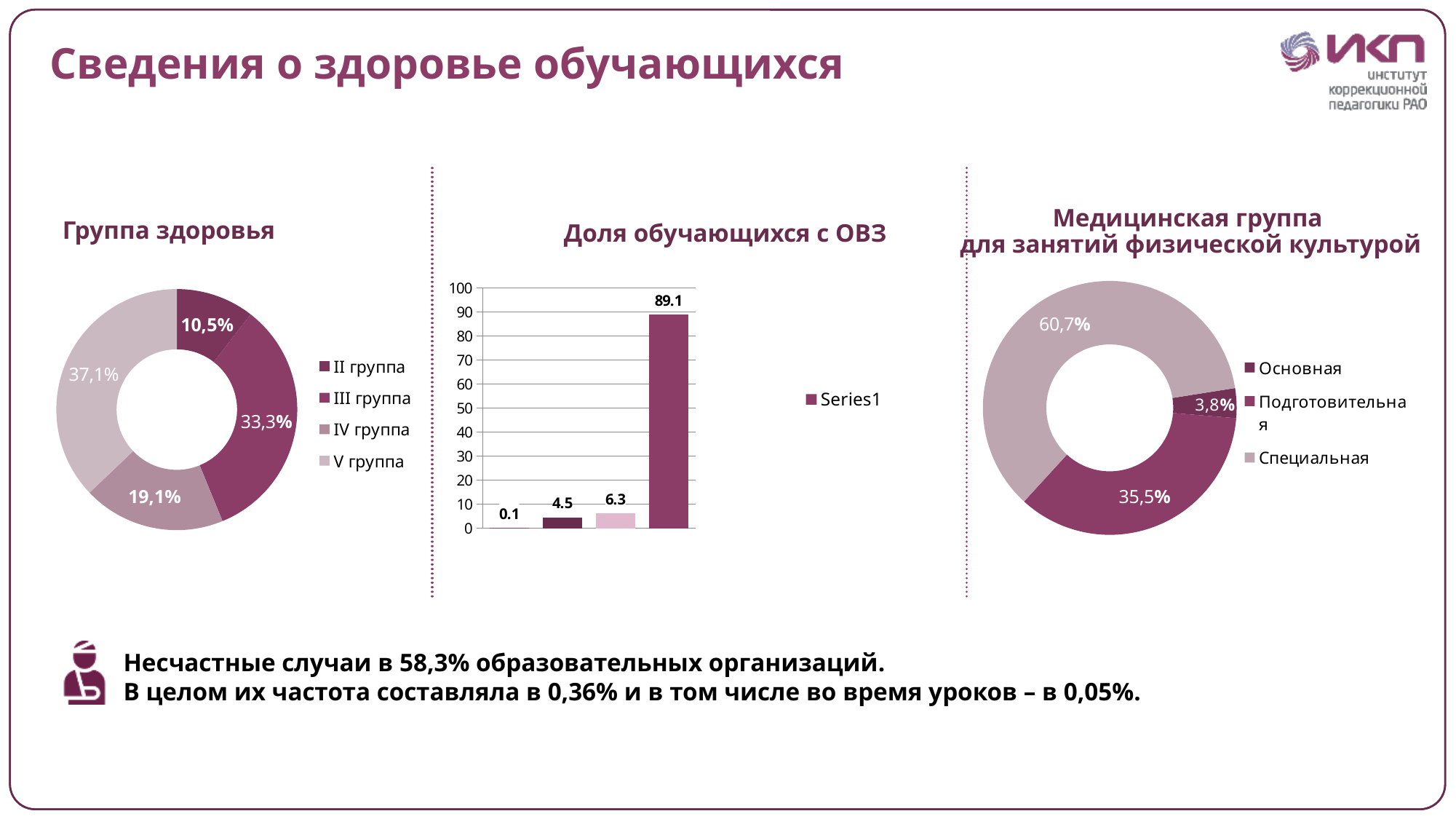
In the 'Группа здоровья' chart, what is the value for III группа? 33,3% What kind of chart is 'Доля обучающихся с ОВЗ'? bar chart In the 'Медицинская группа для занятий физической культурой' chart, what is the value for Специальная? 60,7% In the 'Группа здоровья' chart, which group has the largest share? V группа In the 'Доля обучающихся с ОВЗ' chart, what is the value of the tallest bar? 89.1 In the 'Доля обучающихся с ОВЗ' chart, how many bars are plotted? 4 In the 'Группа здоровья' chart, which group has the smallest share? II группа In the 'Медицинская группа для занятий физической культурой' chart, which is larger: Основная or Подготовительная? Подготовительная In the 'Группа здоровья' chart, what is the difference between the shares of IV группа and II группа? 8,6% How many entries does the legend of the 'Группа здоровья' chart list? 4 In the 'Группа здоровья' chart, what is the value for V группа? 37,1% In the 'Доля обучающихся с ОВЗ' chart, what is the value of the smallest bar? 0.1